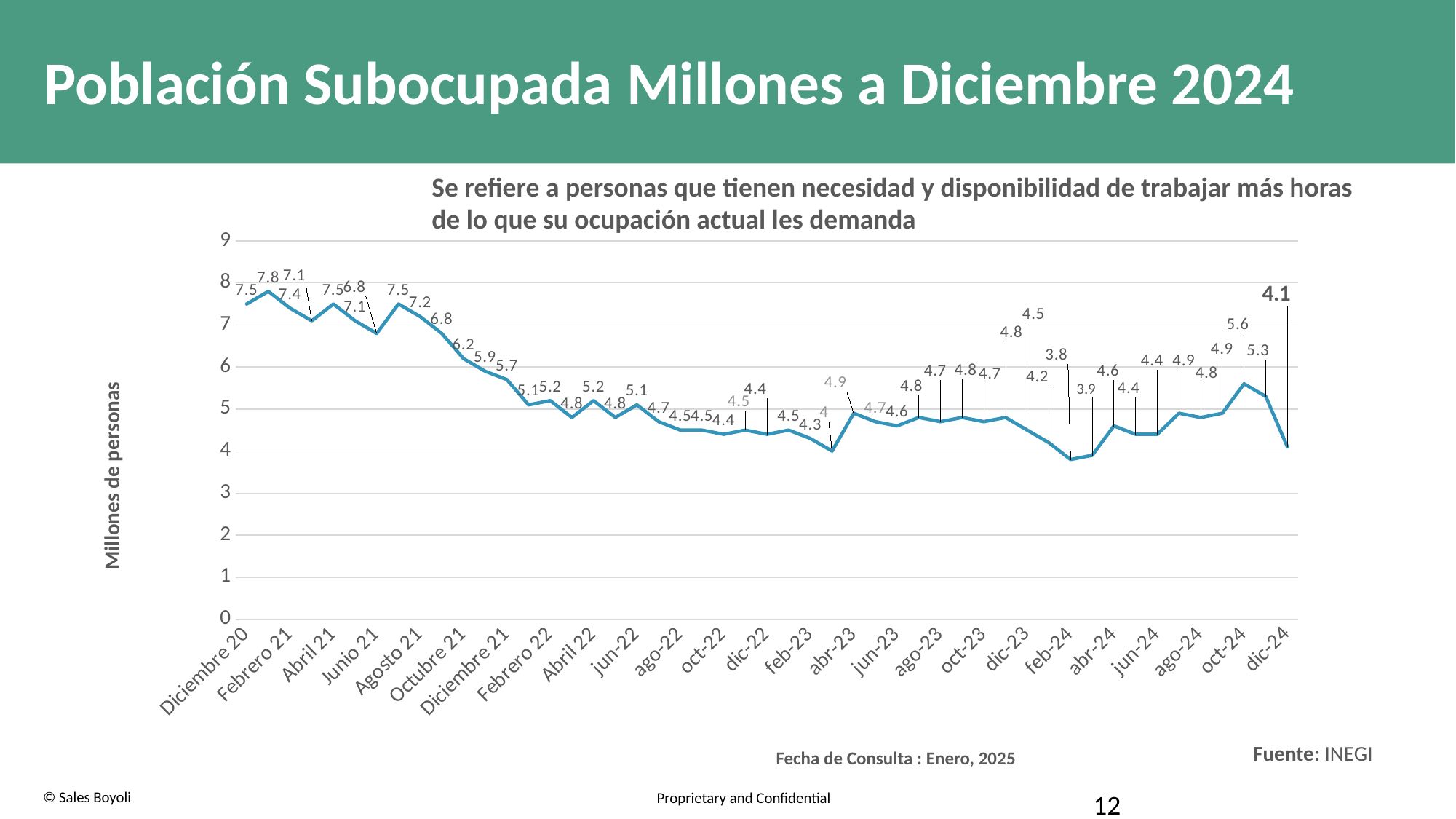
What kind of chart is shown on the slide? line chart Is the value for Diciembre 20 greater or less than 7? greater What is the title of the vertical axis? Millones de personas Which is larger, the value for Diciembre 20 or the value for dic-24? Diciembre 20 What is the lowest value plotted on the chart? 3.8 How many labels are shown on the x axis? 25 What is the value for dic-24? 4.1 What is the value for Diciembre 20, the first point on the chart? 7.5 Is the value for dic-24 greater or less than 5? less Overall, do the values rise or fall from Diciembre 20 to dic-24? fall What is the highest value plotted on the chart? 7.8 What is the difference between the value for Diciembre 20 (7.5) and the value for dic-24 (4.1)? 3.4